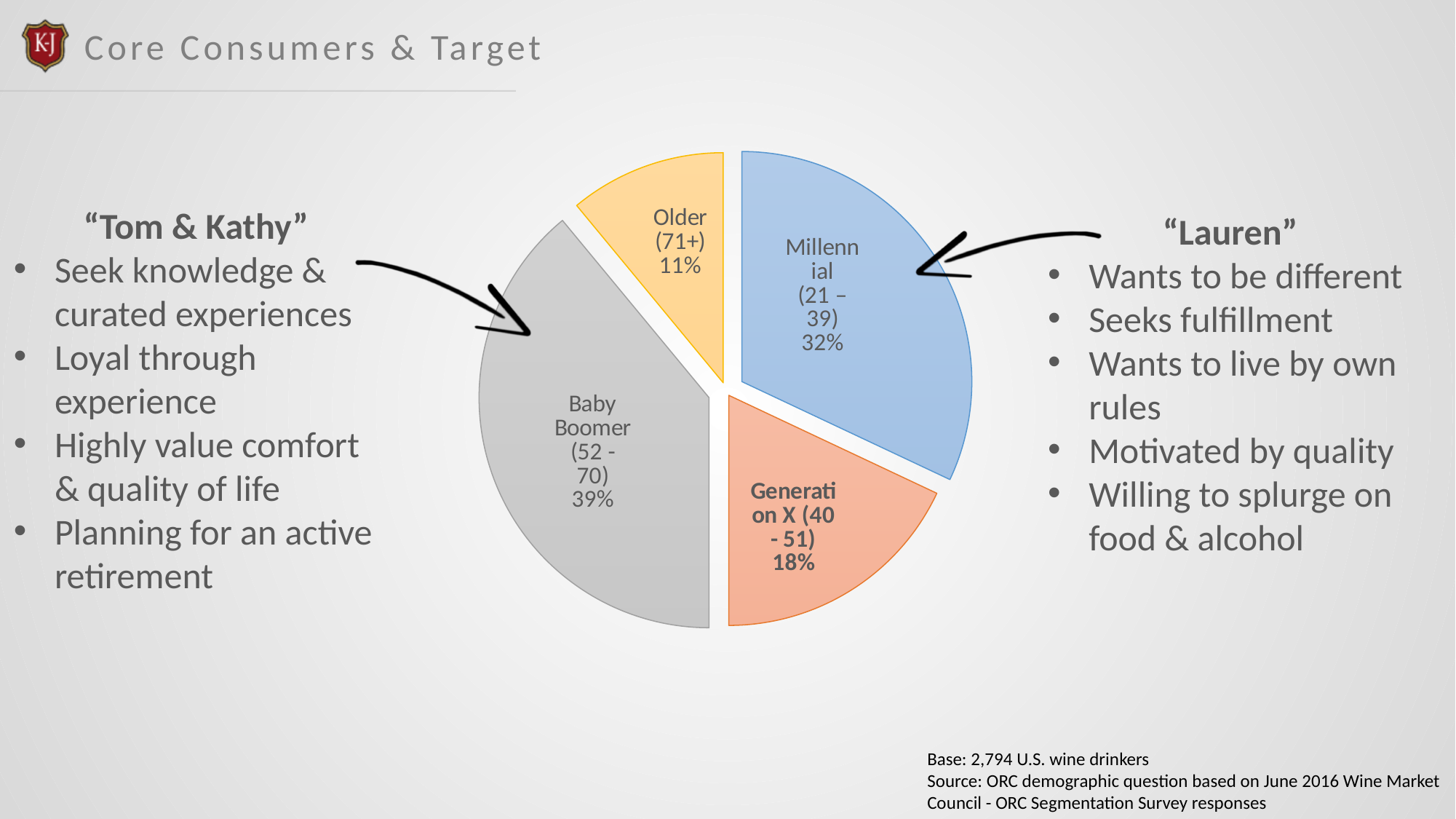
Which is larger, the Generation X slice or the Older (71+) slice? Generation X (40 - 51) What is the difference in percentage points between the Baby Boomer slice and the Millennial slice? 7 What colour is the Millennial (21 – 39) slice? blue Which slice of the pie is the largest? Baby Boomer (52 - 70) What share of the pie does the Generation X (40 - 51) slice represent? 18% What kind of chart is shown on the slide? pie chart What share of the pie does the Older (71+) slice represent? 11% What share of the pie does the Baby Boomer (52 - 70) slice represent? 39% How many slices does the pie chart have? 4 What share of the pie does the Millennial (21 – 39) slice represent? 32% Which slice of the pie is the smallest? Older (71+) What is the combined share of the Millennial and Generation X slices? 50%